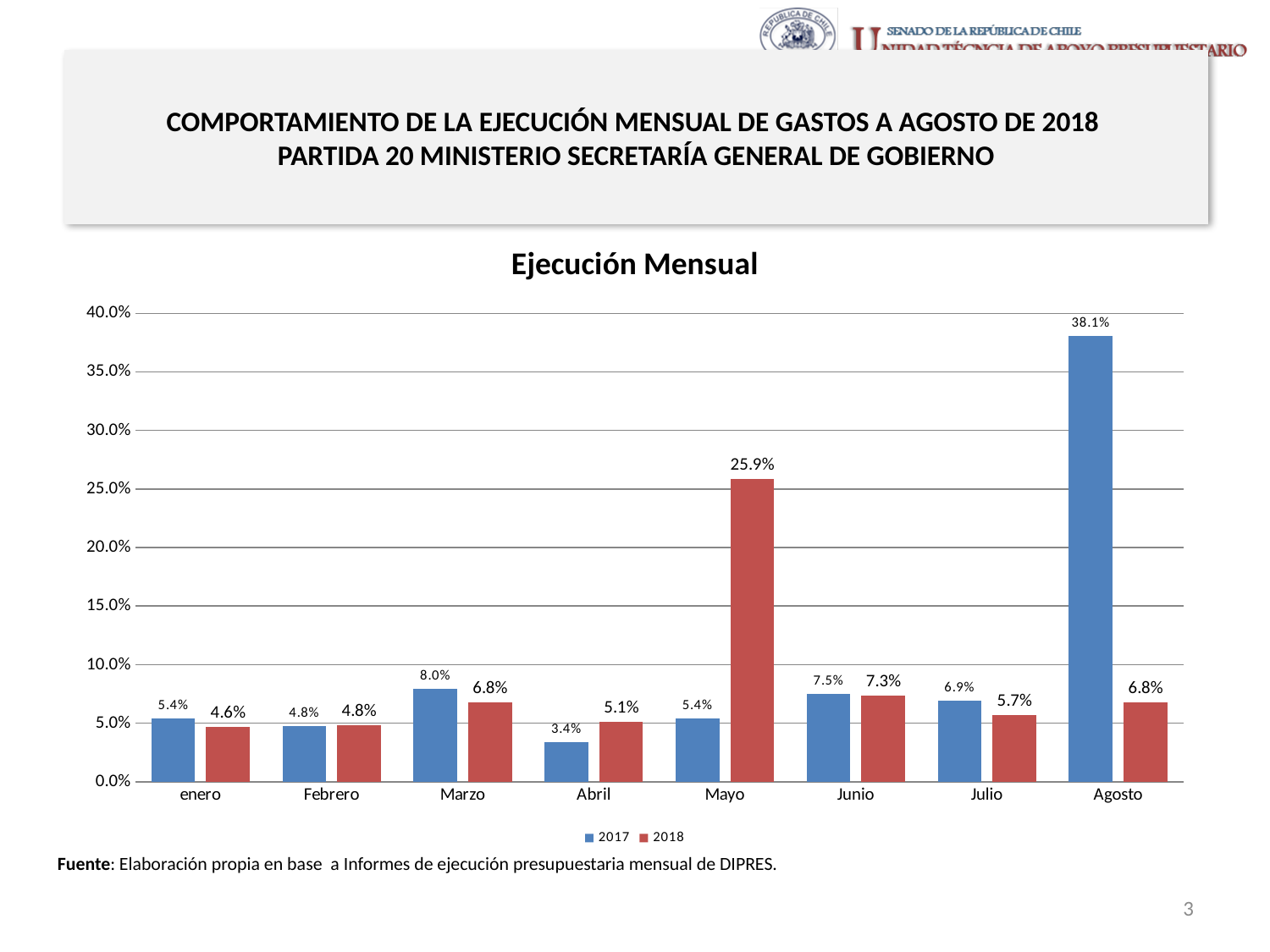
What kind of chart is shown? bar chart Which is larger in Marzo, the 2017 value or the 2018 value? 2017 What is the value for 2017 in Abril? 3.4% What is the value for 2017 in Agosto? 38.1% What is the value for 2018 in Mayo? 25.9% What is the title of the chart? Ejecución Mensual How many series does the legend list? 2 What is the difference between the 2017 and 2018 values in Agosto? 31.3% How many months are shown on the x axis? 8 Which month has the lowest value for the 2017 series? Abril Which month has the highest value for the 2018 series? Mayo Is the value for 2018 in Mayo greater or less than 25.0%? greater